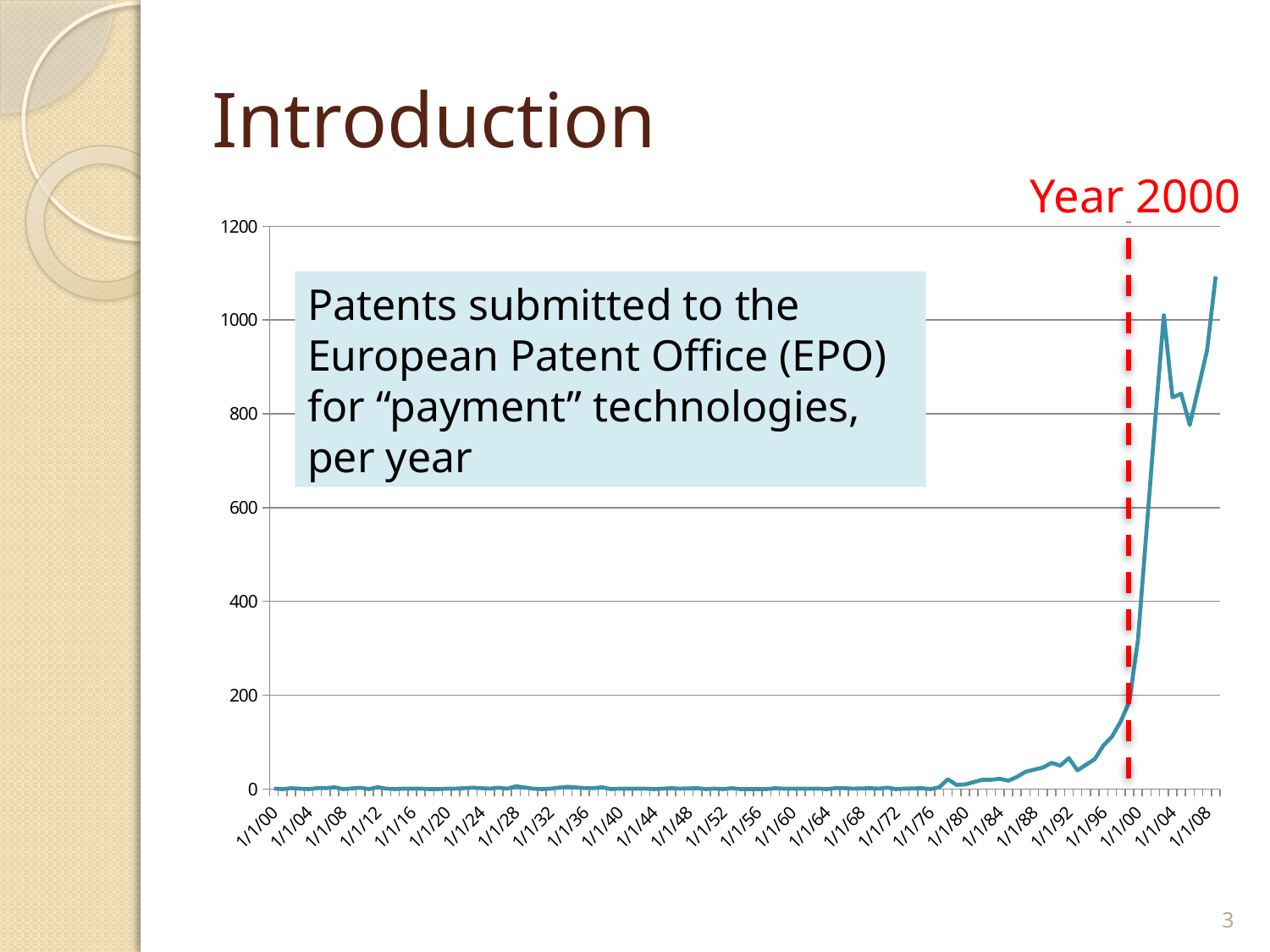
Which is larger, the value at 1/1/08 or the value at 1/1/96? 1/1/08 Do the values generally rise or fall along the x axis after the year 2000? rise Is the value at 1/1/04 greater or less than 600? greater According to the text box on the chart, what does the chart show? Patents submitted to the European Patent Office (EPO) for "payment" technologies, per year How many date labels are shown along the x axis? 28 Is the value at 1/1/80 greater or less than 200? less What year does the red dashed vertical line on the chart mark? Year 2000 What kind of chart is shown on the slide? line chart Is the value at 1/1/96 greater or less than 200? less What is the highest value shown on the y axis? 1200